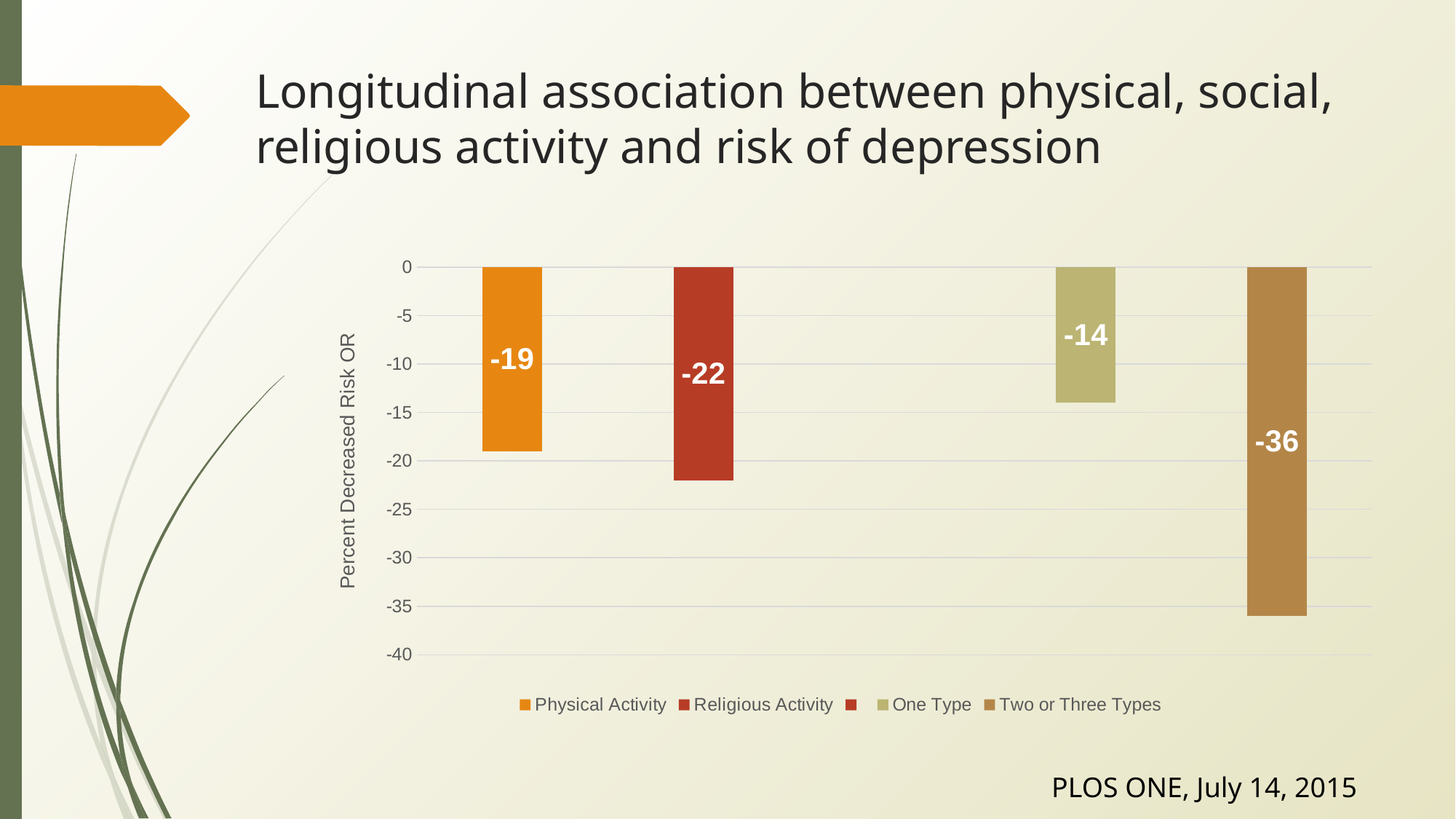
What is the label of the vertical axis? Percent Decreased Risk OR What is the difference between the values for Two or Three Types and One Type? 22 How many bars are plotted in the chart? 4 Which bar shows the largest decrease in risk (the lowest value)? Two or Three Types What value is shown for Physical Activity? -19 What value is shown for Two or Three Types? -36 Which shows a larger decrease in risk, Physical Activity or Religious Activity? Religious Activity What value is shown for One Type? -14 Which bar shows the smallest decrease in risk (the value closest to 0)? One Type What is the difference between the values for Religious Activity and Physical Activity? 3 What value is shown for Religious Activity? -22 What kind of chart is shown on the slide? Bar chart